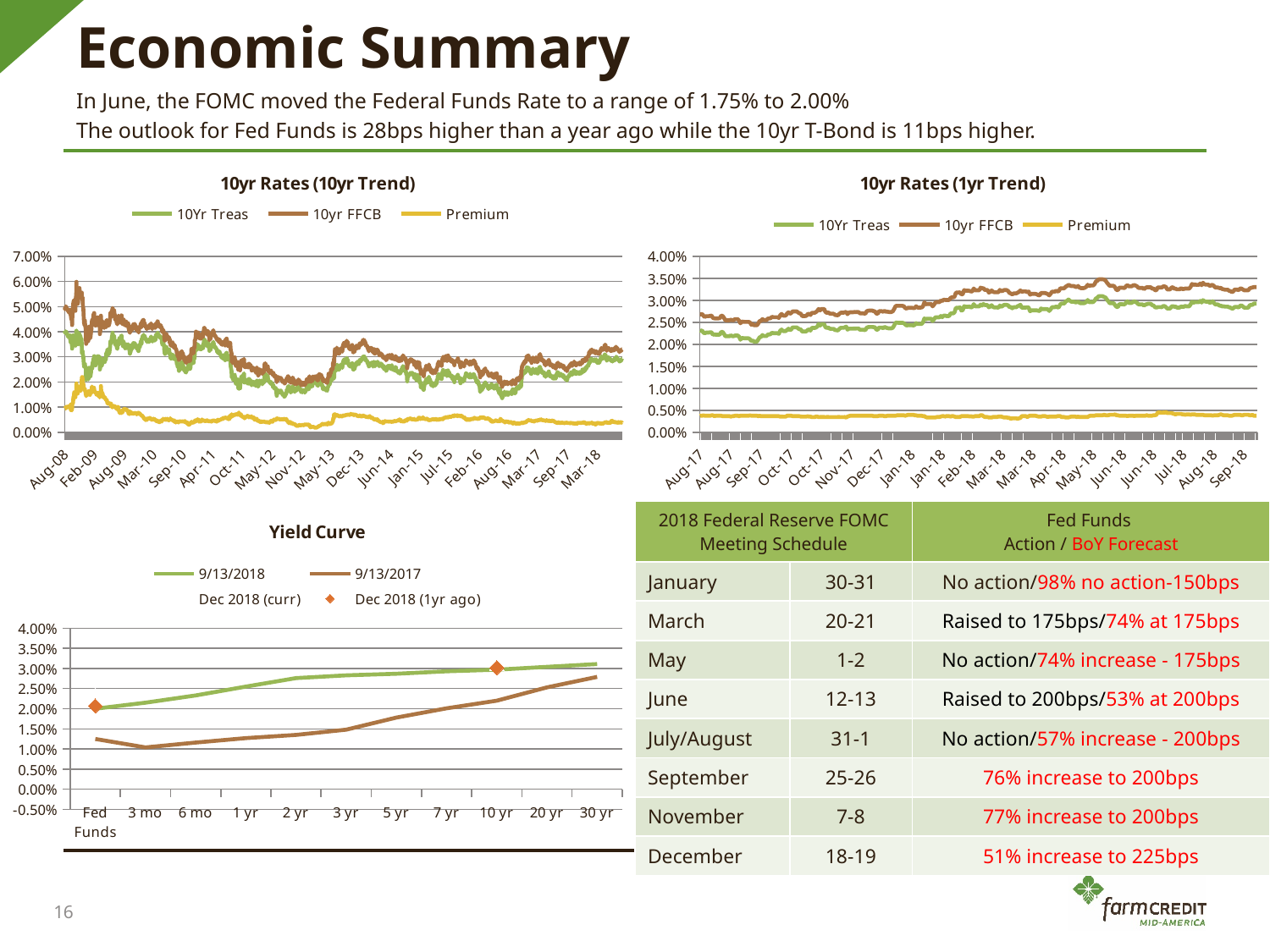
How many entries does the legend of the 'Yield Curve' chart list? 4 In the '10yr Rates (10yr Trend)' chart, which series is drawn in yellow? Premium What kind of chart is the '10yr Rates (10yr Trend)' chart? line chart In the '10yr Rates (1yr Trend)' chart, is the value for 10yr FFCB at Sep-18 greater or less than 3.00%? greater In the '10yr Rates (1yr Trend)' chart, is the value for 10Yr Treas at Aug-17 greater or less than 3.00%? less In the 'Yield Curve' chart, does the 9/13/2018 line rise or fall from Fed Funds to 30 yr? rise How many categories are shown on the x axis of the 'Yield Curve' chart? 11 In the '10yr Rates (1yr Trend)' chart, is the value for Premium at Sep-18 greater or less than 1.00%? less How many series does the legend of the '10yr Rates (10yr Trend)' chart list? 3 In the 'Yield Curve' chart, at 30 yr, which is higher: 9/13/2018 or 9/13/2017? 9/13/2018 In the '10yr Rates (1yr Trend)' chart, which series is the highest across the whole period? 10yr FFCB In the '10yr Rates (1yr Trend)' chart, does the 10yr FFCB series rise or fall from Aug-17 to Sep-18? rise